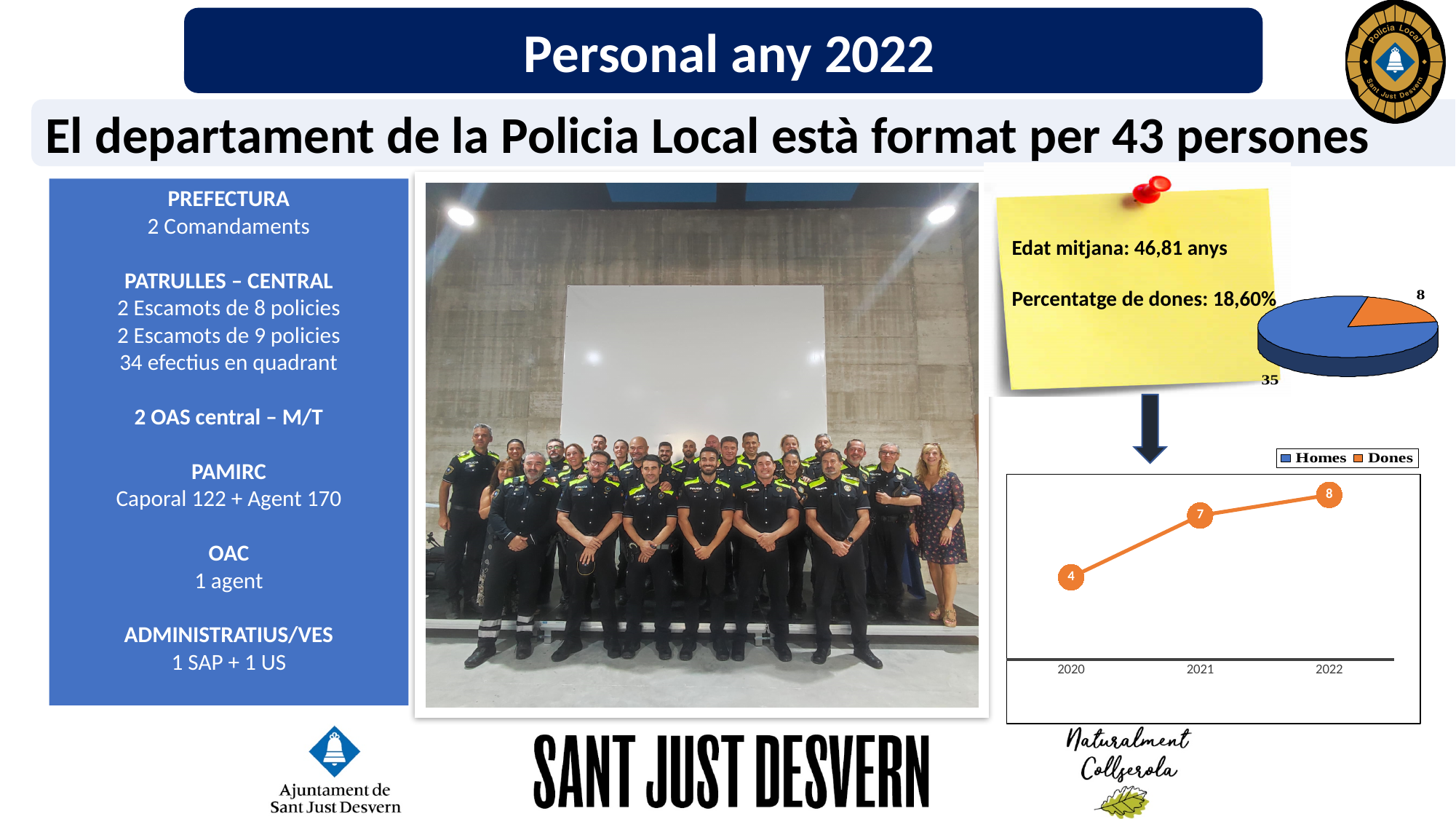
What kind of chart is the chart at the bottom right with years 2020, 2021 and 2022? line chart In the pie chart, what value is shown for the blue slice (Homes)? 35 In the line chart, what is the difference between the 2022 value and the 2020 value? 4 In the pie chart, which slice is larger, Homes or Dones? Homes In the pie chart, what value is shown for the orange slice (Dones)? 8 In the pie chart, how many slices are there? 2 In the line chart, what is the value for 2021? 7 In the line chart, do the values rise or fall from 2020 to 2022? rise In the line chart, what is the value for 2020? 4 In the line chart, what is the value for 2022? 8 In the pie chart, what is the difference between the Homes value and the Dones value? 27 How many entries does the Homes/Dones legend list? 2